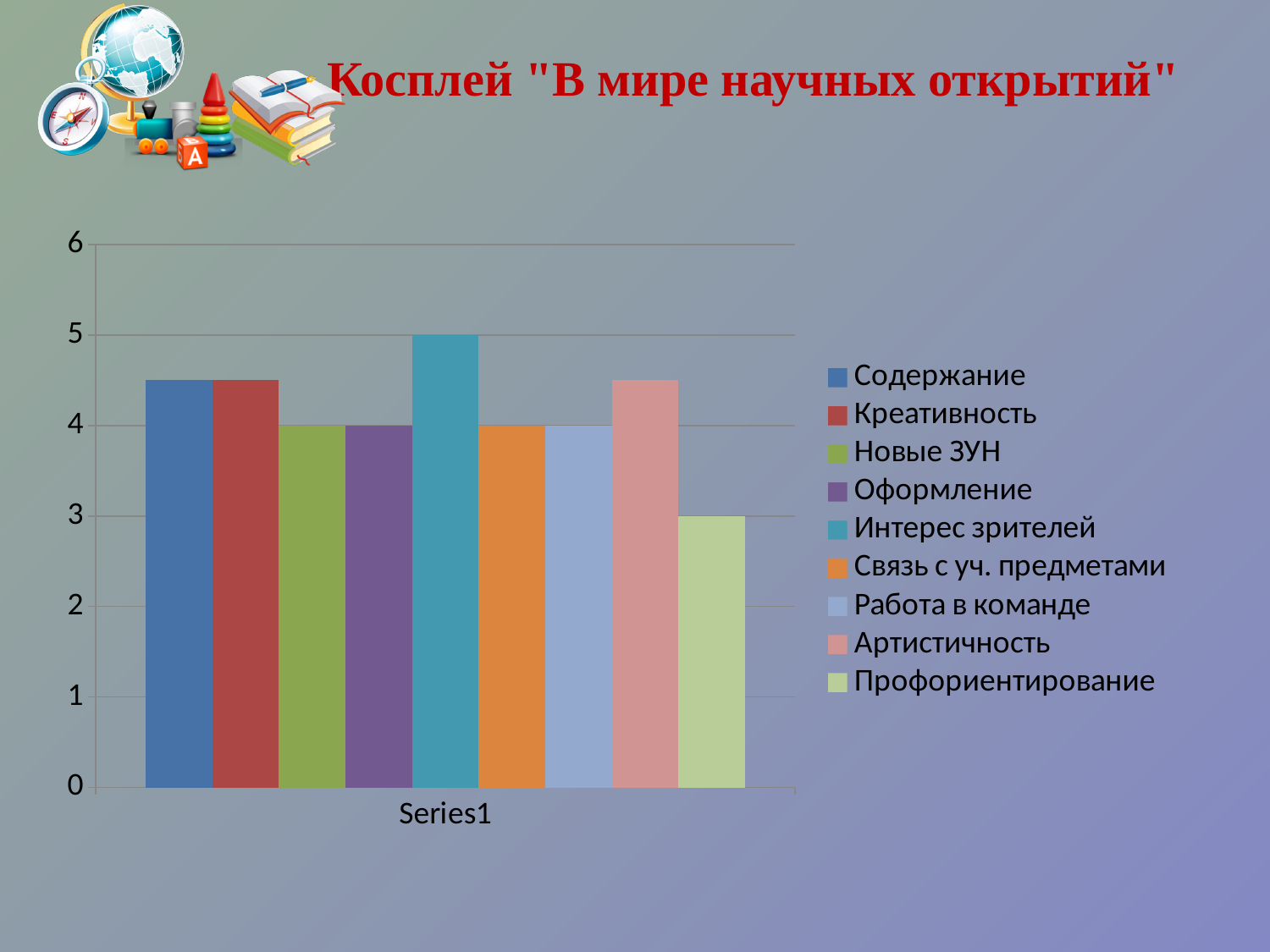
What is the value for Профориентирование? 3 Is the value for Артистичность greater or less than 5? less Which series has the lowest value? Профориентирование How many series does the legend list? 9 Which is larger, the value for Работа в команде or the value for Профориентирование? Работа в команде Is the value for Содержание greater or less than 4? greater What is the category label shown on the x axis? Series1 What kind of chart is shown on the slide? bar chart What is the difference between the values for Интерес зрителей and Профориентирование? 2 Which series has the highest value? Интерес зрителей What is the value for Интерес зрителей? 5 What is the value for Новые ЗУН? 4